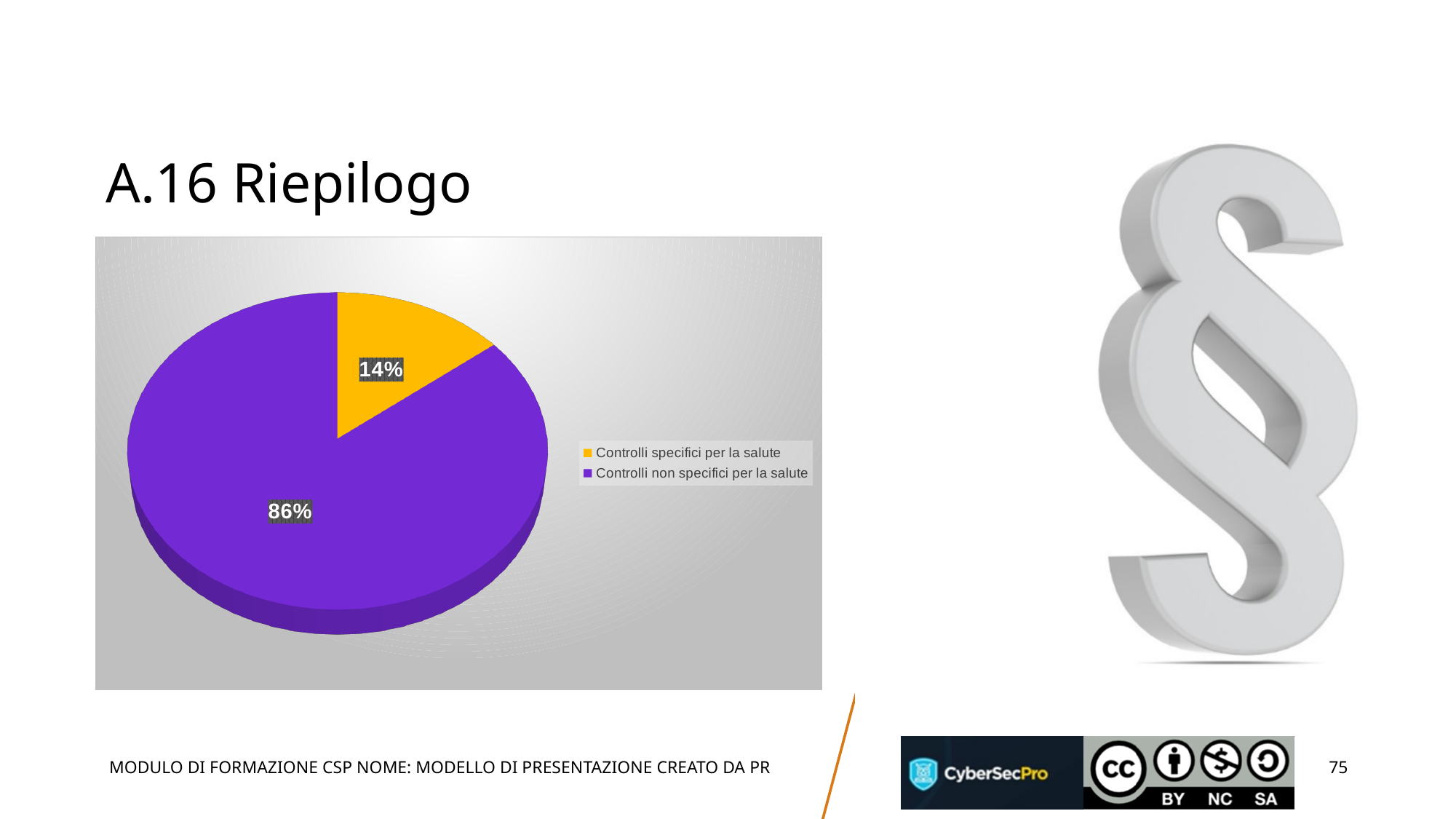
What share of the pie is 'Controlli specifici per la salute'? 14% What is the difference in percentage points between 'Controlli non specifici per la salute' and 'Controlli specifici per la salute'? 72 Which is larger: 'Controlli specifici per la salute' or 'Controlli non specifici per la salute'? Controlli non specifici per la salute What kind of chart is shown on the slide? Pie chart What colour is the slice for 'Controlli non specifici per la salute'? Purple How many slices does the pie chart have? 2 What colour is the slice for 'Controlli specifici per la salute'? Yellow What share of the pie is 'Controlli non specifici per la salute'? 86% Which category has the largest slice of the pie? Controlli non specifici per la salute How many entries does the legend list? 2 Which category has the smallest slice of the pie? Controlli specifici per la salute